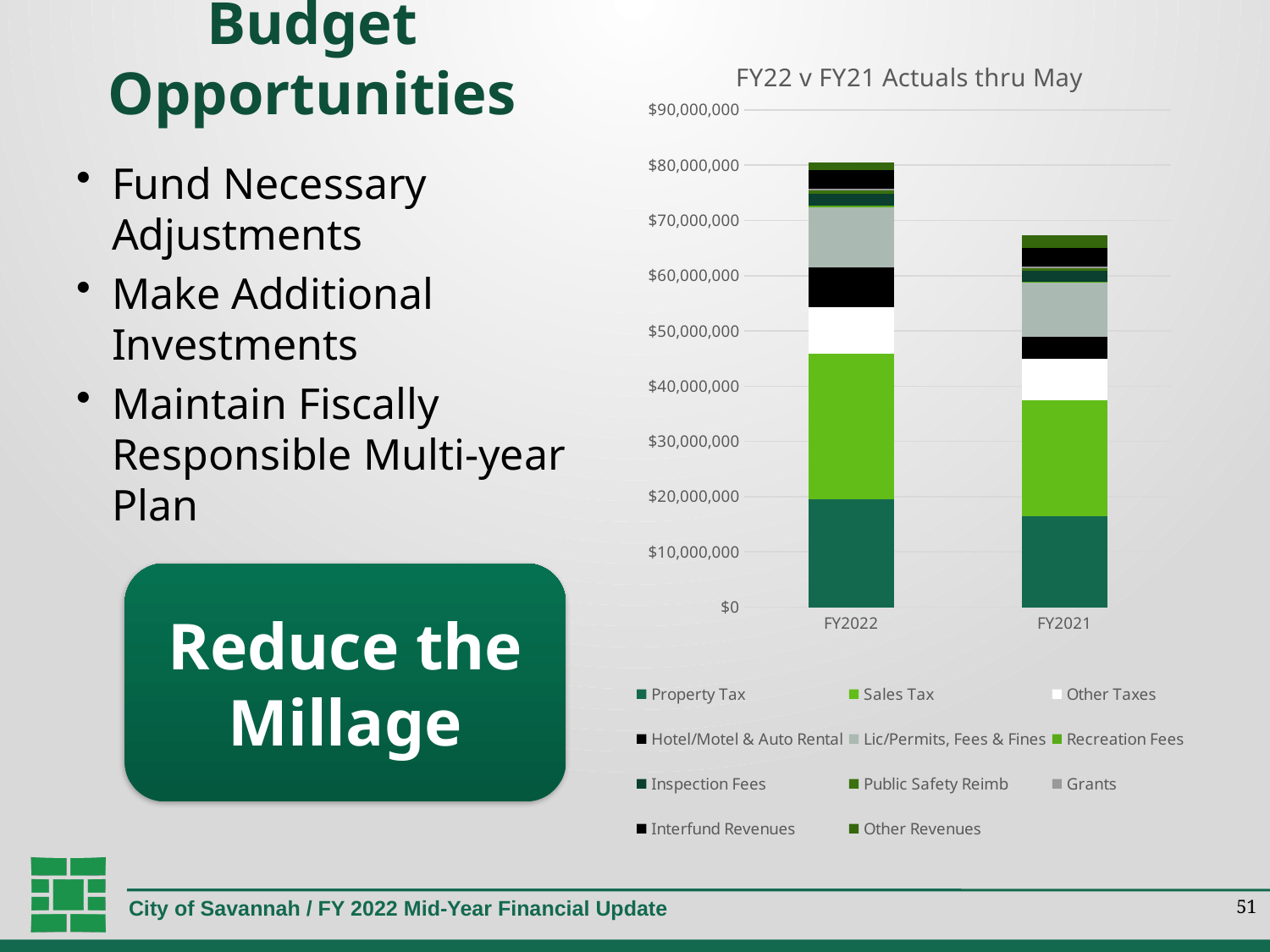
How many series does the chart's legend list? 11 What kind of chart is shown on the slide? Stacked bar chart How many categories are shown on the x axis of the chart? 2 What is the highest value shown on the chart's y axis? $90,000,000 Which series is listed first in the chart's legend? Property Tax Which fiscal year has the taller stacked bar, FY2022 or FY2021? FY2022 Is the Property Tax value for FY2021 greater or less than $20,000,000? less Which category has the lower total, FY2022 or FY2021? FY2021 Is the total of the FY2021 bar greater or less than $70,000,000? less Is the total of the FY2021 bar greater or less than $60,000,000? greater What is the title of the chart? FY22 v FY21 Actuals thru May